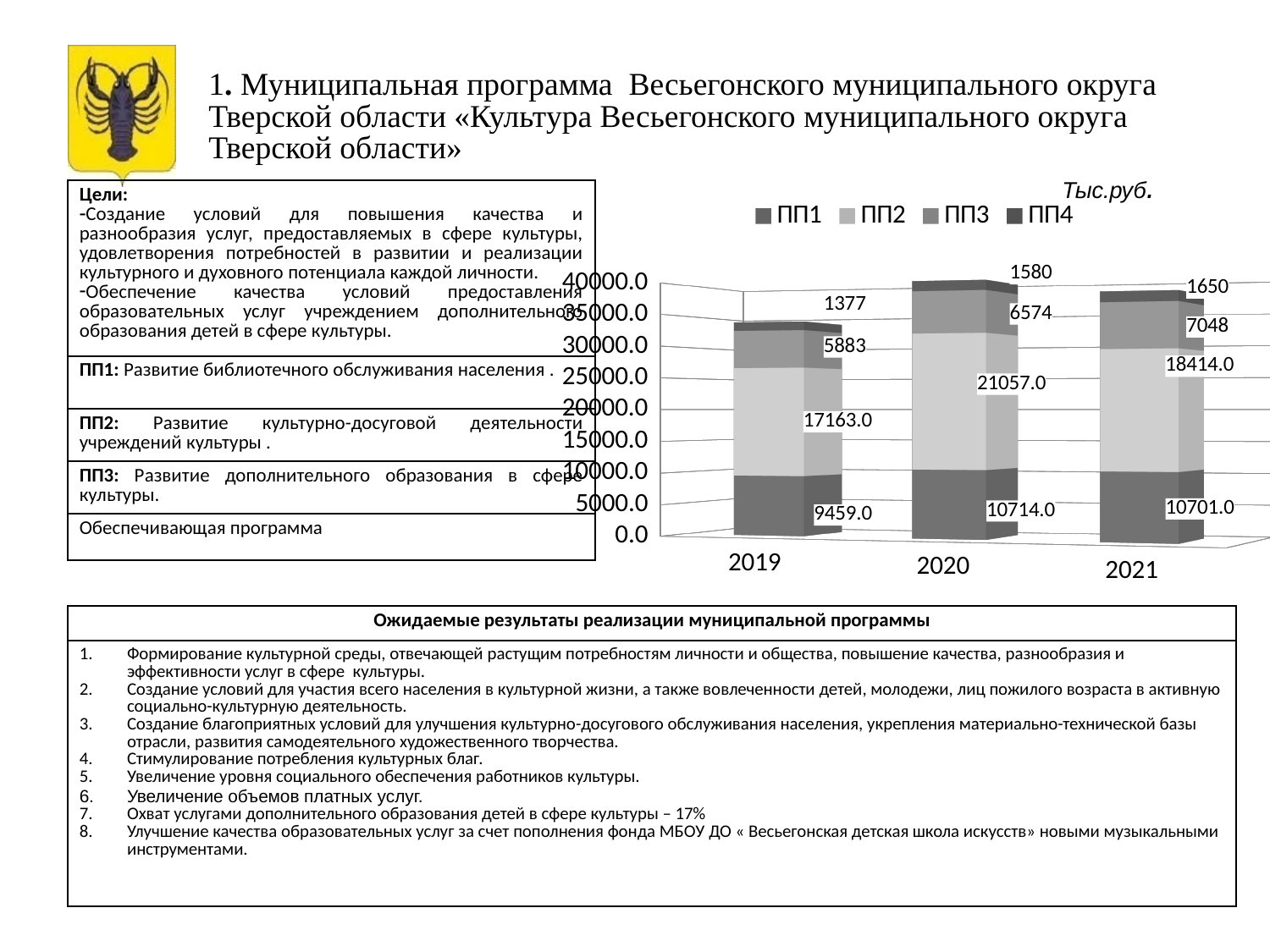
What is the total of the stacked bar for 2019? 33882 What is the value of ПП1 in 2019? 9459.0 What type of chart is shown on the slide? stacked bar chart What is the value of ПП4 in 2021? 1650 Which is larger, the ПП1 value in 2020 or in 2021? 2020 What is the value of ПП2 in 2020? 21057.0 How many series does the chart legend list? 4 What is the difference between the ПП3 values in 2021 and 2019? 1165 In which year is the value of ПП4 the lowest? 2019 What is the value of ПП3 in 2020? 6574 In which year is the value of ПП2 the highest? 2020 How many years are shown on the x axis of the chart? 3